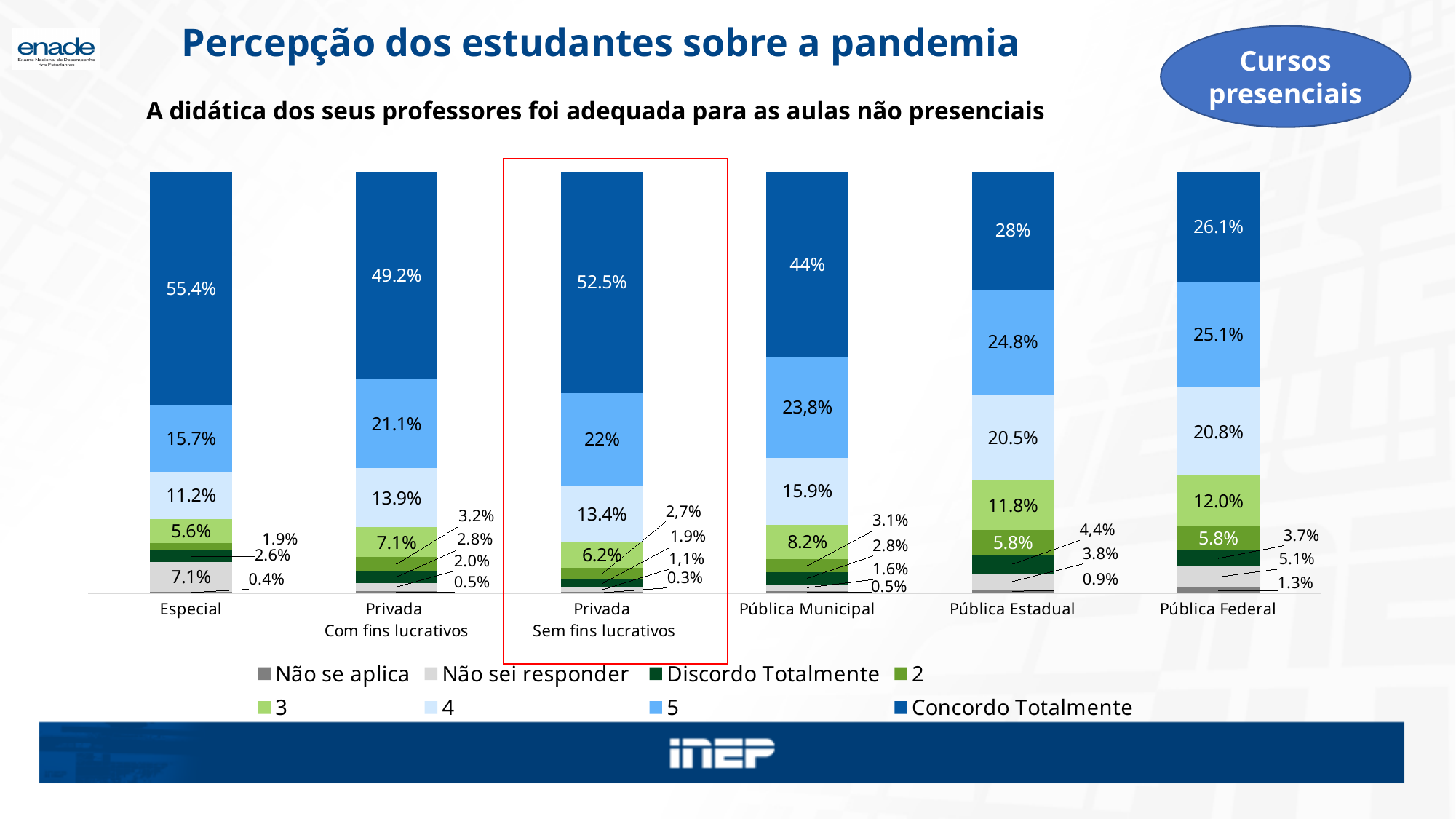
What is the value of series '3' for Pública Federal? 12.0% Which is larger: the series '5' value for Especial or for Privada Sem fins lucrativos? Privada Sem fins lucrativos How many series does the legend list? 8 Which category has the highest 'Concordo Totalmente' value? Especial How many categories (institution types) are shown on the x axis? 6 What is the difference between the 'Concordo Totalmente' values for Especial and Pública Federal? 29.3 percentage points What is the value of series '5' for Pública Estadual? 24.8% Which category has the lowest 'Concordo Totalmente' value? Pública Federal What is the value of 'Concordo Totalmente' for Especial? 55.4% What is the value of series '4' for Pública Municipal? 15.9% What kind of chart is shown on the slide? Stacked bar chart Which category is highlighted with a red box on the chart? Privada Sem fins lucrativos